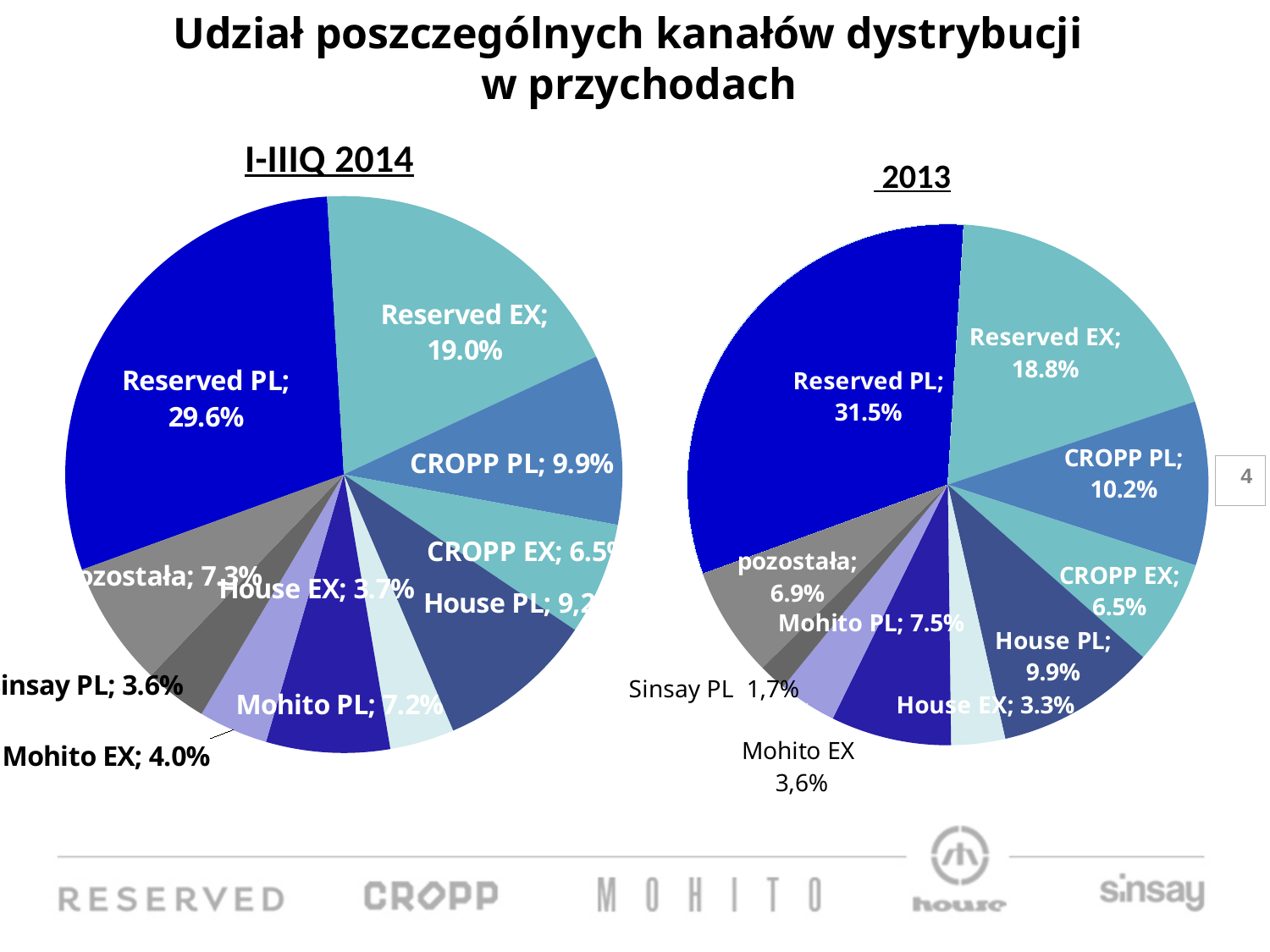
In the 2013 chart, which channel has the smallest share? Sinsay PL In the I-IIIQ 2014 chart, what is the share of Reserved EX? 19.0% What is the difference between the Reserved PL share in 2013 and in I-IIIQ 2014? 1.9 percentage points In the I-IIIQ 2014 chart, which channel has the largest share? Reserved PL How many slices does the 2013 pie chart have? 10 In the 2013 chart, what is the share of House EX? 3.3% What type of charts are shown on the slide? pie charts In the I-IIIQ 2014 chart, what is the share of Reserved PL? 29.6% In the 2013 chart, what is the share of Sinsay PL? 1,7% In the I-IIIQ 2014 chart, which is larger: Mohito PL or Mohito EX? Mohito PL In the 2013 chart, what is the share of Reserved PL? 31.5% In the 2013 chart, what is the share of CROPP PL? 10.2%